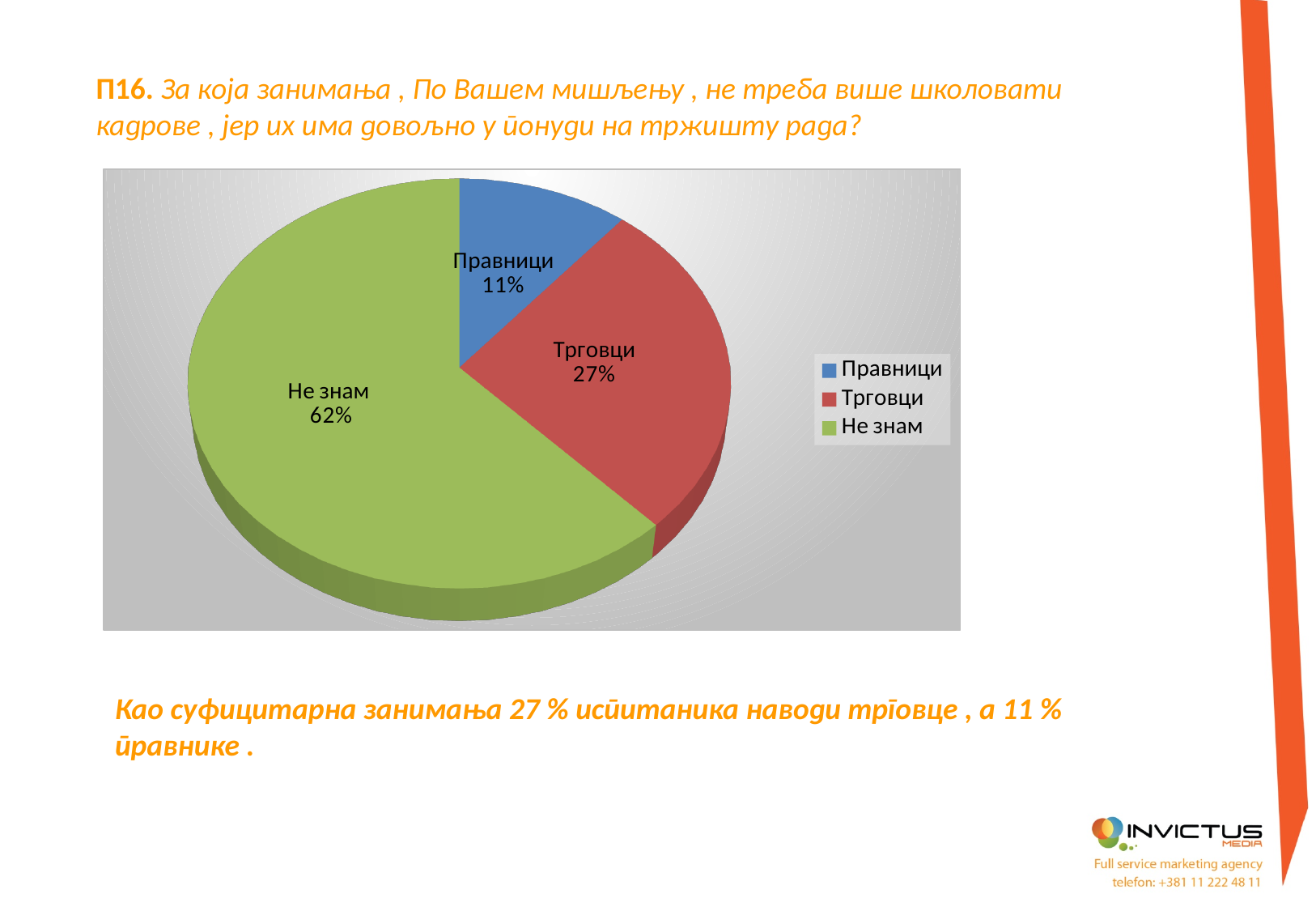
What colour is the "Не знам" slice? Green Which category has the largest slice of the pie? Не знам Which category has the smallest slice of the pie? Правници What is the difference between the values for "Не знам" and "Трговци"? 35% Which is larger, the value for "Трговци" or the value for "Правници"? Трговци What is the value shown for "Правници"? 11% What is the value shown for "Трговци"? 27% How many slices does the pie chart have? 3 What share of the pie does the "Не знам" slice represent? 62% How many entries does the legend list? 3 What kind of chart is shown on the slide? Pie chart What is the difference between the values for "Трговци" and "Правници"? 16%